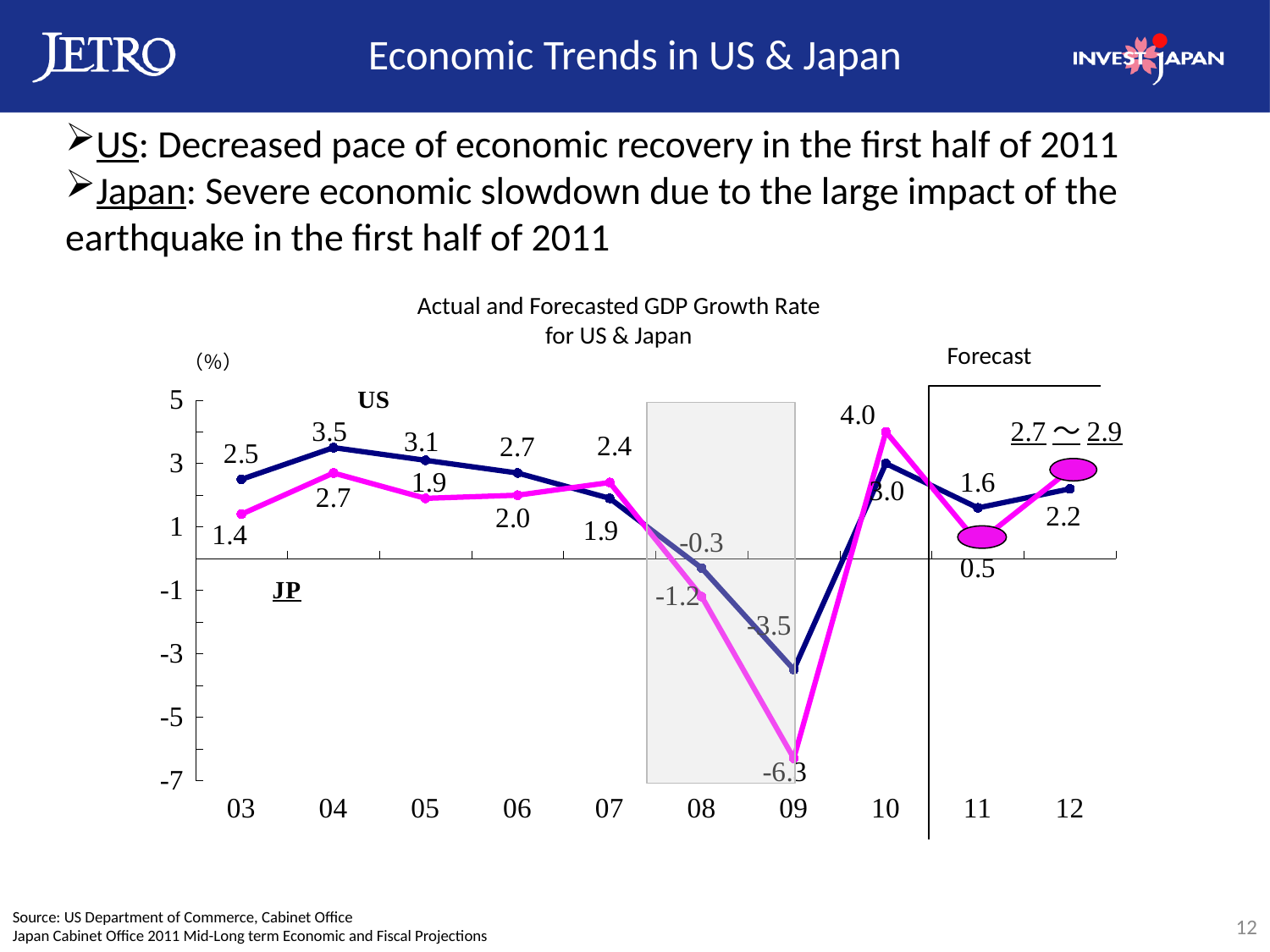
What is the forecasted US GDP growth rate for 11? 1.6 How many series (countries) are plotted on the chart? 2 What was the US GDP growth rate in 04? 3.5 How many years are shown on the x axis of the chart? 10 What is the forecasted JP GDP growth rate for 12? 2.7～2.9 What kind of chart is shown on the slide? line chart In 10, which had the higher GDP growth rate, US or JP? JP What was Japan's (JP) GDP growth rate in 09? -6.3 What was Japan's (JP) GDP growth rate in 10? 4.0 In which year did the US line reach its highest value? 04 By how much did the US growth rate increase from 03 to 04? 1.0 In which year did the JP line reach its lowest value? 09